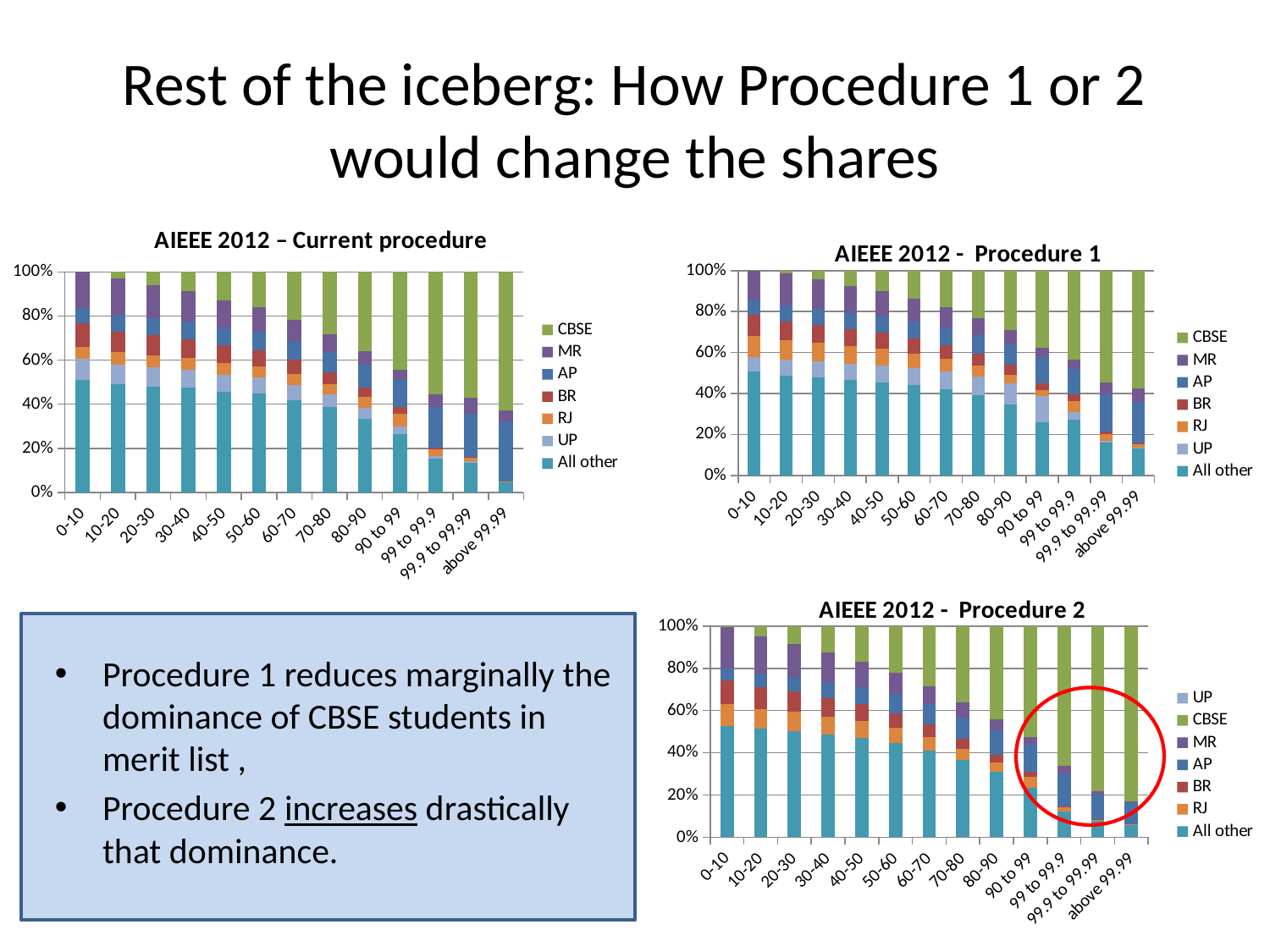
In the "AIEEE 2012 - Procedure 2" chart, is the "All other" share for the 0-10 category greater or less than 40%? greater In the "AIEEE 2012 – Current procedure" chart, how many categories are shown on the x axis? 13 In the "AIEEE 2012 – Current procedure" chart, does the CBSE share rise or fall moving from 0-10 to "above 99.99" along the x axis? rise In the "AIEEE 2012 - Procedure 2" chart, does the "All other" share rise or fall moving from 0-10 to "above 99.99" along the x axis? fall In the "AIEEE 2012 - Procedure 2" chart, which series is listed first in the legend? UP What kind of chart is the "AIEEE 2012 – Current procedure" chart? Stacked bar chart How many series does the legend of the "AIEEE 2012 - Procedure 1" chart list? 7 In the "AIEEE 2012 - Procedure 1" chart, is the "All other" share for the "above 99.99" category greater or less than 20%? less In the "AIEEE 2012 – Current procedure" chart, is the "All other" share for the 0-10 category greater or less than 40%? greater How many charts are shown on the slide? 3 What is the title of the chart at the bottom right of the slide? AIEEE 2012 - Procedure 2